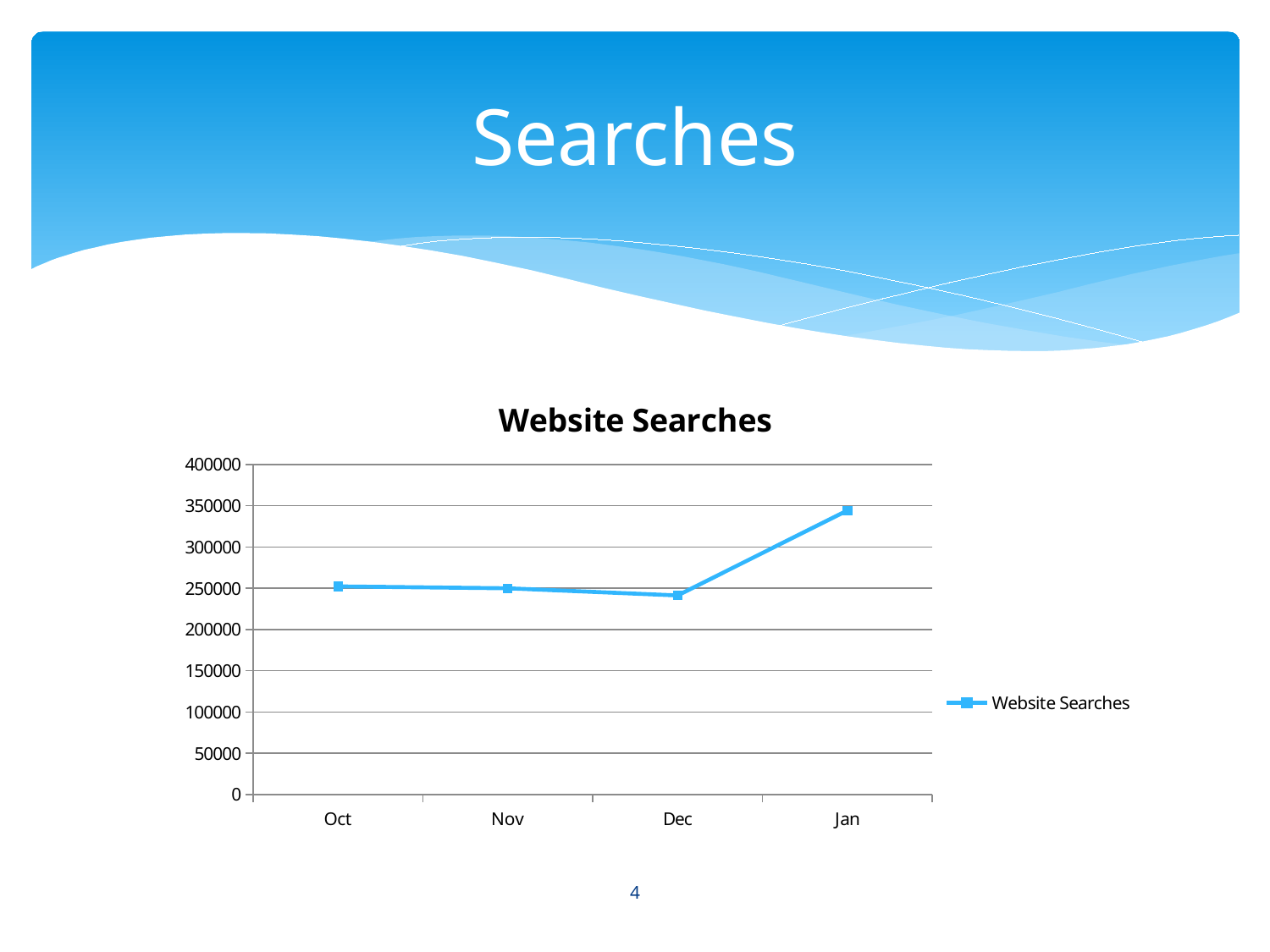
What kind of chart is shown on the slide? line chart How many series does the legend list? 1 What is the name of the series shown in the legend? Website Searches Which month has the highest number of website searches? Jan Is the value for Jan greater or less than 400000? less Do website searches rise or fall from Dec to Jan? rise Is the value for Dec greater or less than 300000? less How many months are plotted on the x axis? 4 Which is larger, the value for Jan or the value for Oct? Jan What is the title of the chart? Website Searches Is the value for Oct greater or less than 200000? greater